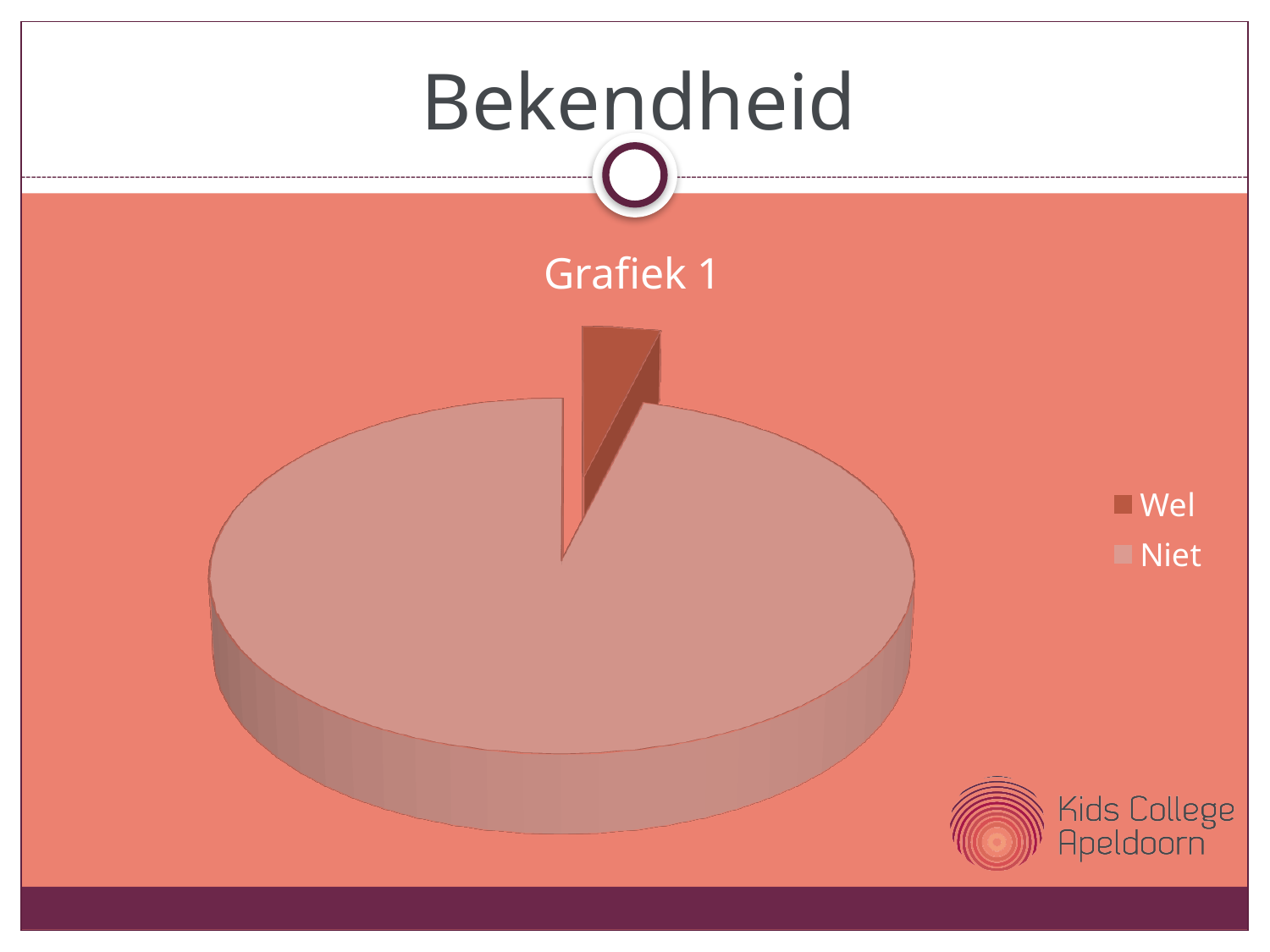
Which legend entry is shown in the darker red-brown colour? Wel How many slices does the pie chart have? 2 Which slice is larger, Wel or Niet? Niet Which category has the smallest slice in the pie chart? Wel What kind of chart is shown on the slide? pie chart How many categories does the legend of the chart list? 2 Which category has the largest slice in the pie chart? Niet What is the title of the chart? Grafiek 1